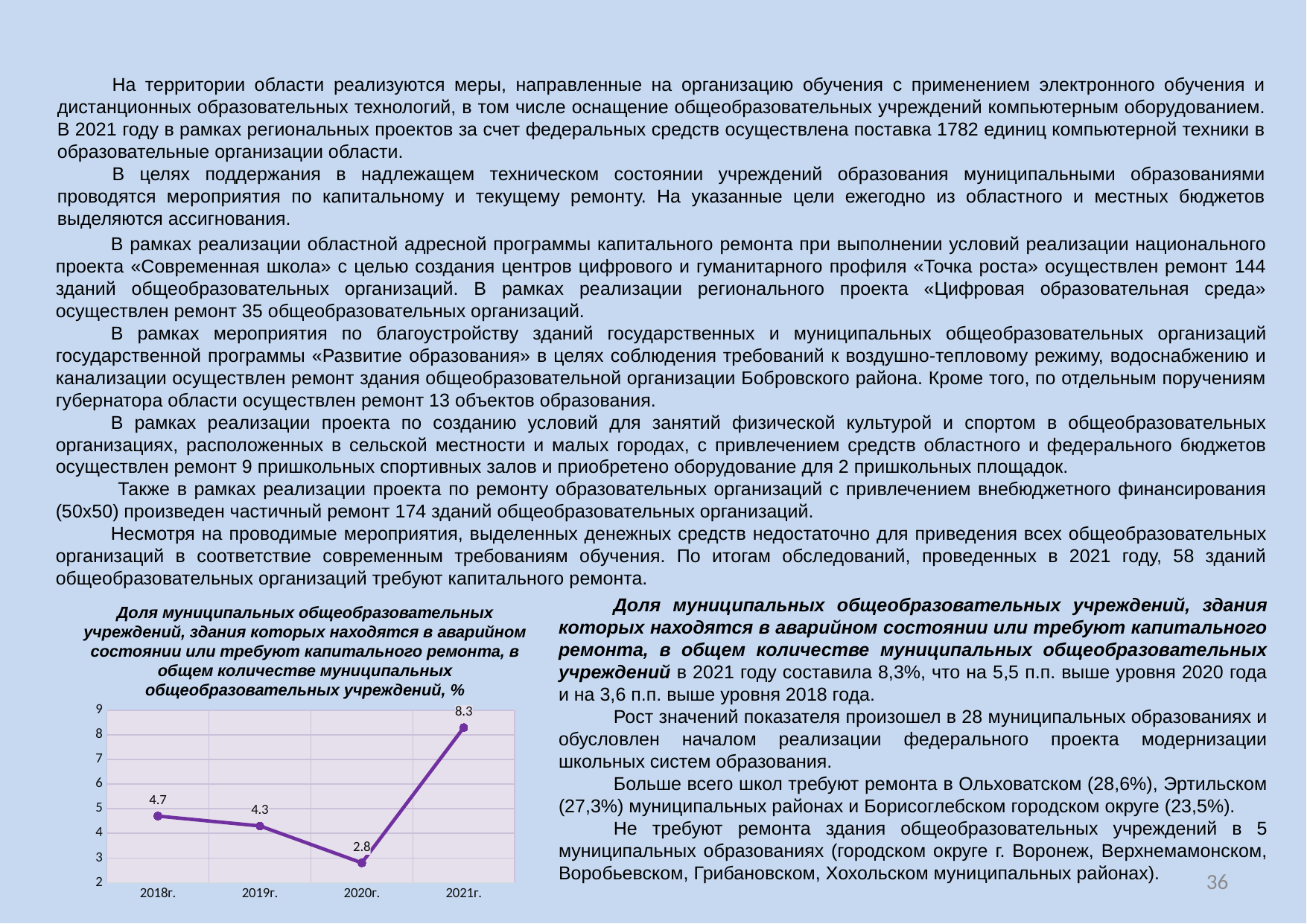
Which year has the lowest value on the chart? 2020г. What is the difference between the values for 2021г. and 2020г.? 5.5 Does the value rise or fall from 2018г. to 2020г.? fall What kind of chart is shown on the slide? line chart What is the value for 2020г. on the chart? 2.8 How many years are plotted on the chart? 4 What is the value for 2021г. on the chart? 8.3 What is the difference between the values for 2018г. and 2019г.? 0.4 Which year has the highest value on the chart? 2021г. Which is larger, the value for 2018г. or the value for 2019г.? 2018г. What is the value for 2018г. on the chart? 4.7 Is the value for 2021г. greater or less than 8? greater